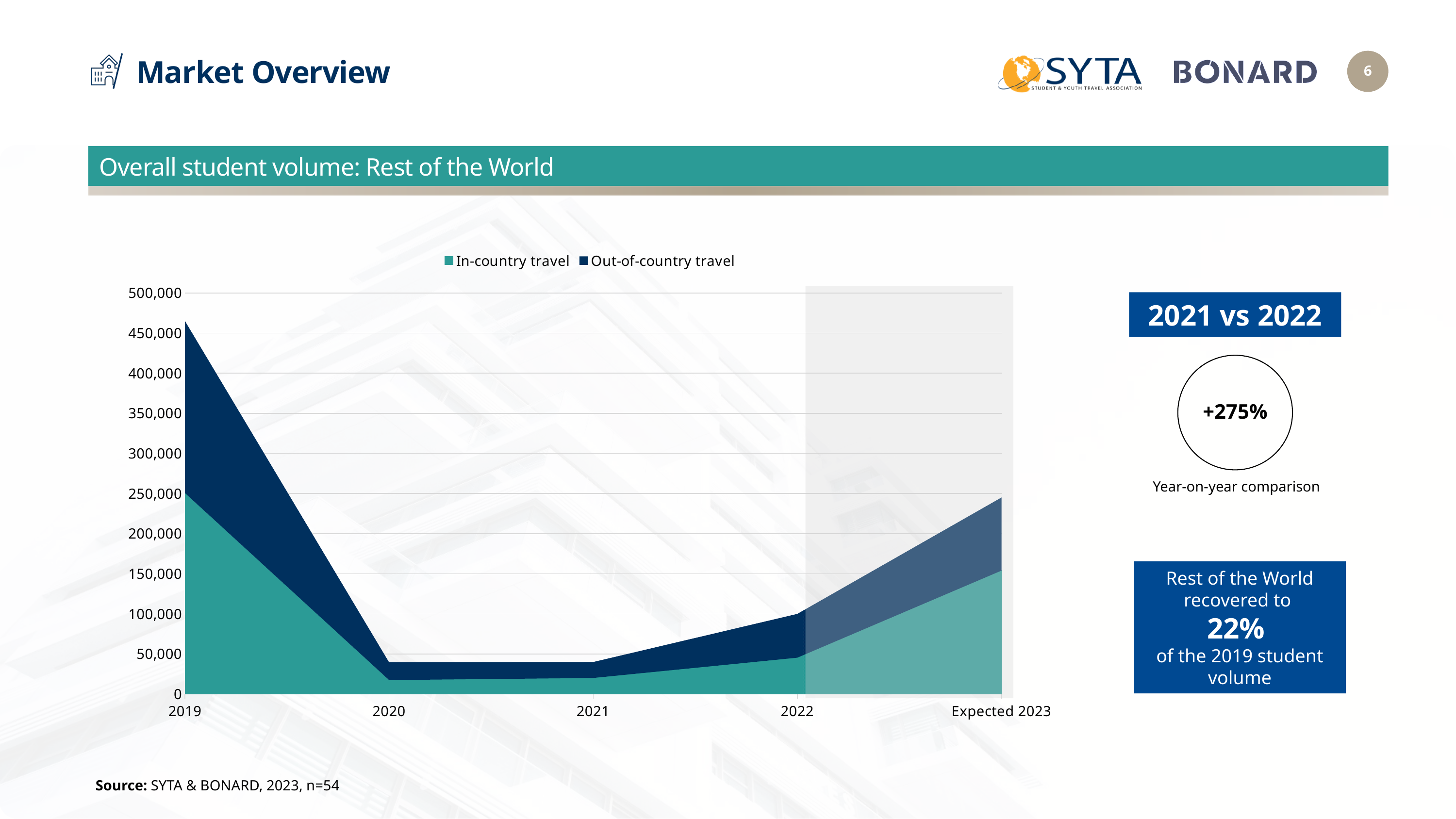
Does the total student volume rise or fall from 2019 to 2020? fall Which is larger, the total student volume in 2022 or in Expected 2023? Expected 2023 Does the total student volume rise or fall from 2021 to Expected 2023? rise Is the In-country travel value for Expected 2023 greater or less than 100,000? greater Is the total student volume in 2019 greater or less than 400,000? greater What kind of chart is shown on the slide? Stacked area chart What is the title of the chart? Overall student volume: Rest of the World Is the total student volume in 2020 greater or less than 100,000? less How many time points are shown on the x axis? 5 Which year has the highest total student volume? 2019 How many series does the legend list? 2